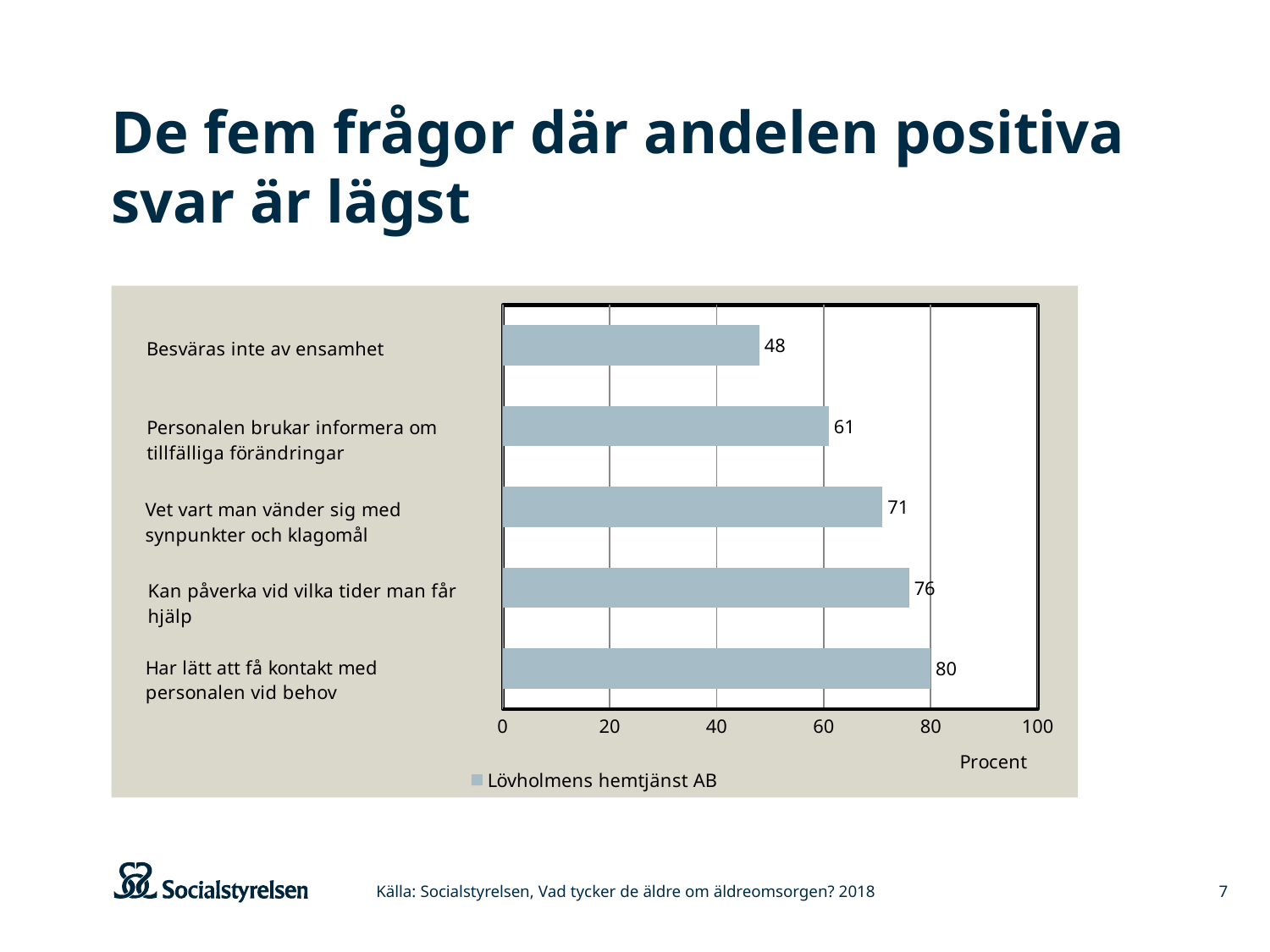
What is the difference between the values for "Har lätt att få kontakt med personalen vid behov" and "Besväras inte av ensamhet"? 32 What kind of chart is shown on the slide? bar chart What is the value for "Vet vart man vänder sig med synpunkter och klagomål"? 71 What is the value for "Har lätt att få kontakt med personalen vid behov"? 80 Which category has the highest value? Har lätt att få kontakt med personalen vid behov What series name is shown in the chart legend? Lövholmens hemtjänst AB What is the value for "Besväras inte av ensamhet"? 48 Is the value for "Personalen brukar informera om tillfälliga förändringar" greater or less than 60? greater Which category has the lowest value? Besväras inte av ensamhet How many series does the legend list? 1 Which is larger: the value for "Personalen brukar informera om tillfälliga förändringar" or the value for "Kan påverka vid vilka tider man får hjälp"? Kan påverka vid vilka tider man får hjälp How many categories are shown in the chart? 5